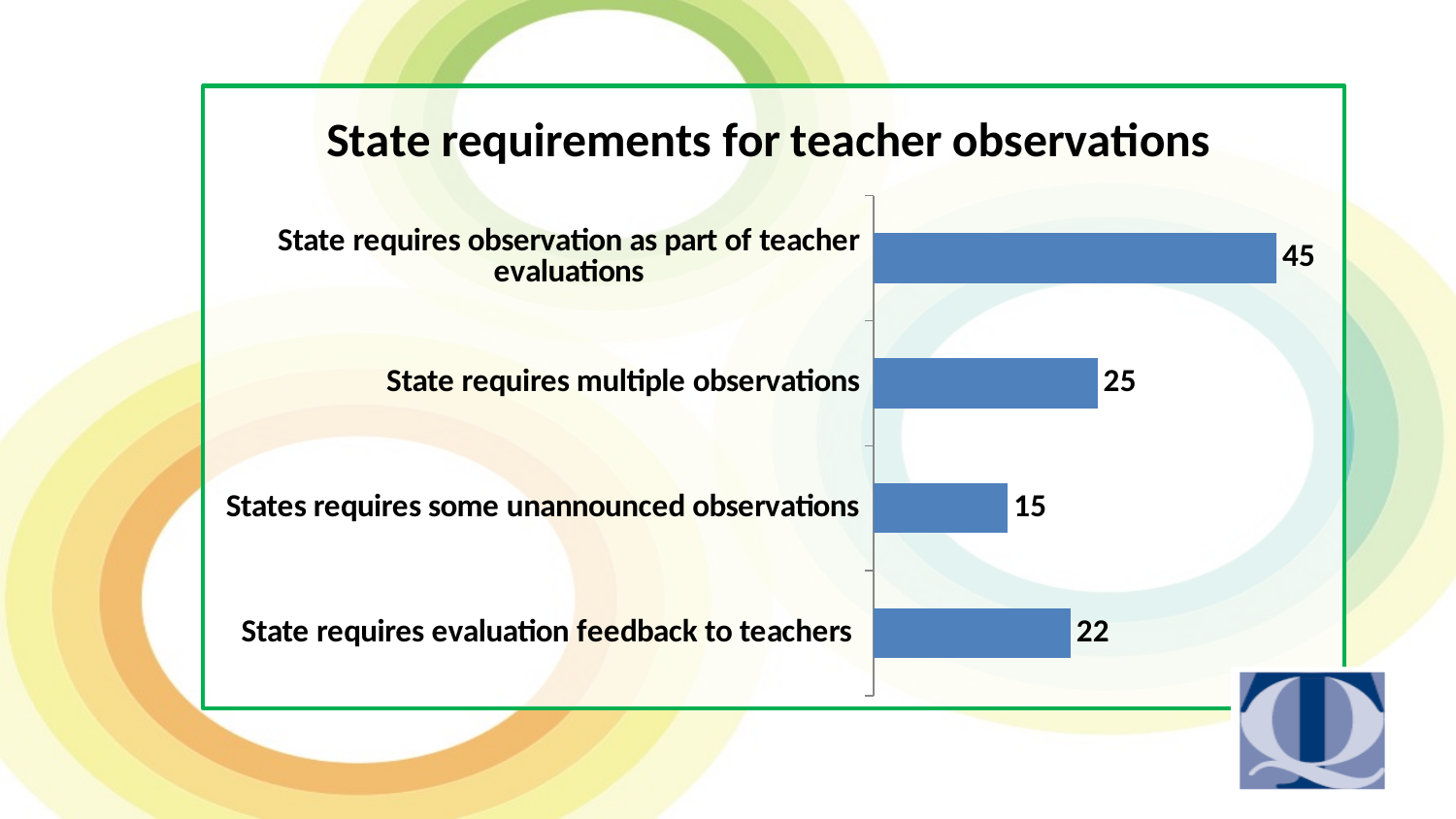
How many categories are shown in the chart? 4 What is the value for 'States requires some unannounced observations'? 15 What kind of chart is shown on the slide? Bar chart What is the difference between the values for 'State requires observation as part of teacher evaluations' and 'State requires multiple observations'? 20 What is the title of the chart? State requirements for teacher observations What is the value for 'State requires observation as part of teacher evaluations'? 45 What is the value for 'State requires evaluation feedback to teachers'? 22 Which is larger: the value for 'State requires multiple observations' or 'State requires evaluation feedback to teachers'? State requires multiple observations What is the difference between the values for 'State requires evaluation feedback to teachers' and 'States requires some unannounced observations'? 7 What is the value for 'State requires multiple observations'? 25 Which category has the lowest value? States requires some unannounced observations Which category has the highest value? State requires observation as part of teacher evaluations